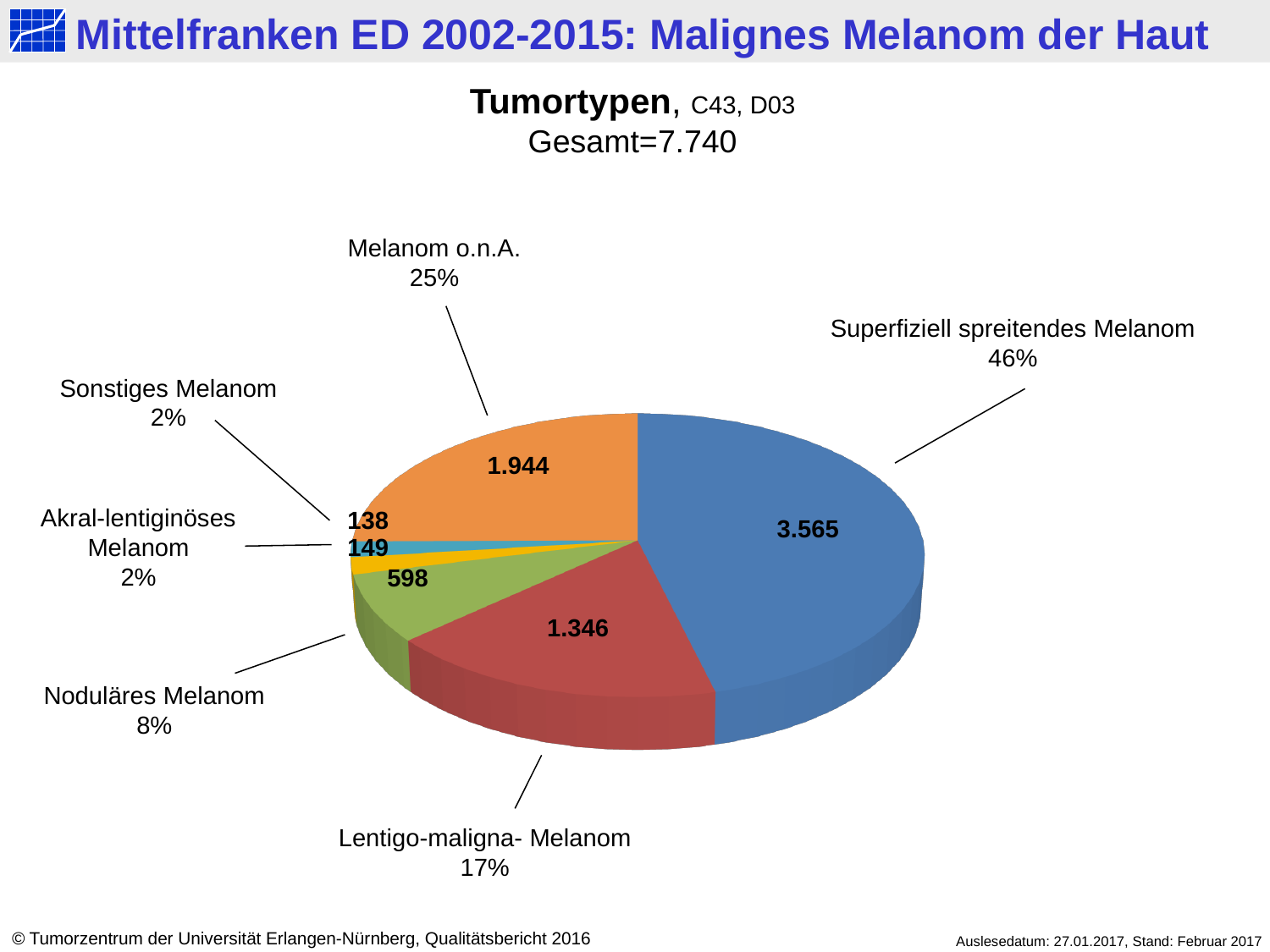
What is the difference between the values for Superfiziell spreitendes Melanom and Melanom o.n.A.? 1.621 Which tumour type has the largest slice of the pie? Superfiziell spreitendes Melanom What share of the pie does Superfiziell spreitendes Melanom have? 46% What is the value for Lentigo-maligna- Melanom? 1.346 What type of chart is shown on the slide? pie chart What total (Gesamt) is stated above the pie chart? 7.740 What is the value for Superfiziell spreitendes Melanom? 3.565 Which is larger, the value for Melanom o.n.A. or the value for Lentigo-maligna- Melanom? Melanom o.n.A. What is the value for Noduläres Melanom? 598 What is the value for Melanom o.n.A.? 1.944 What share of the pie does Lentigo-maligna- Melanom have? 17% How many tumour type categories does the pie chart show? 6